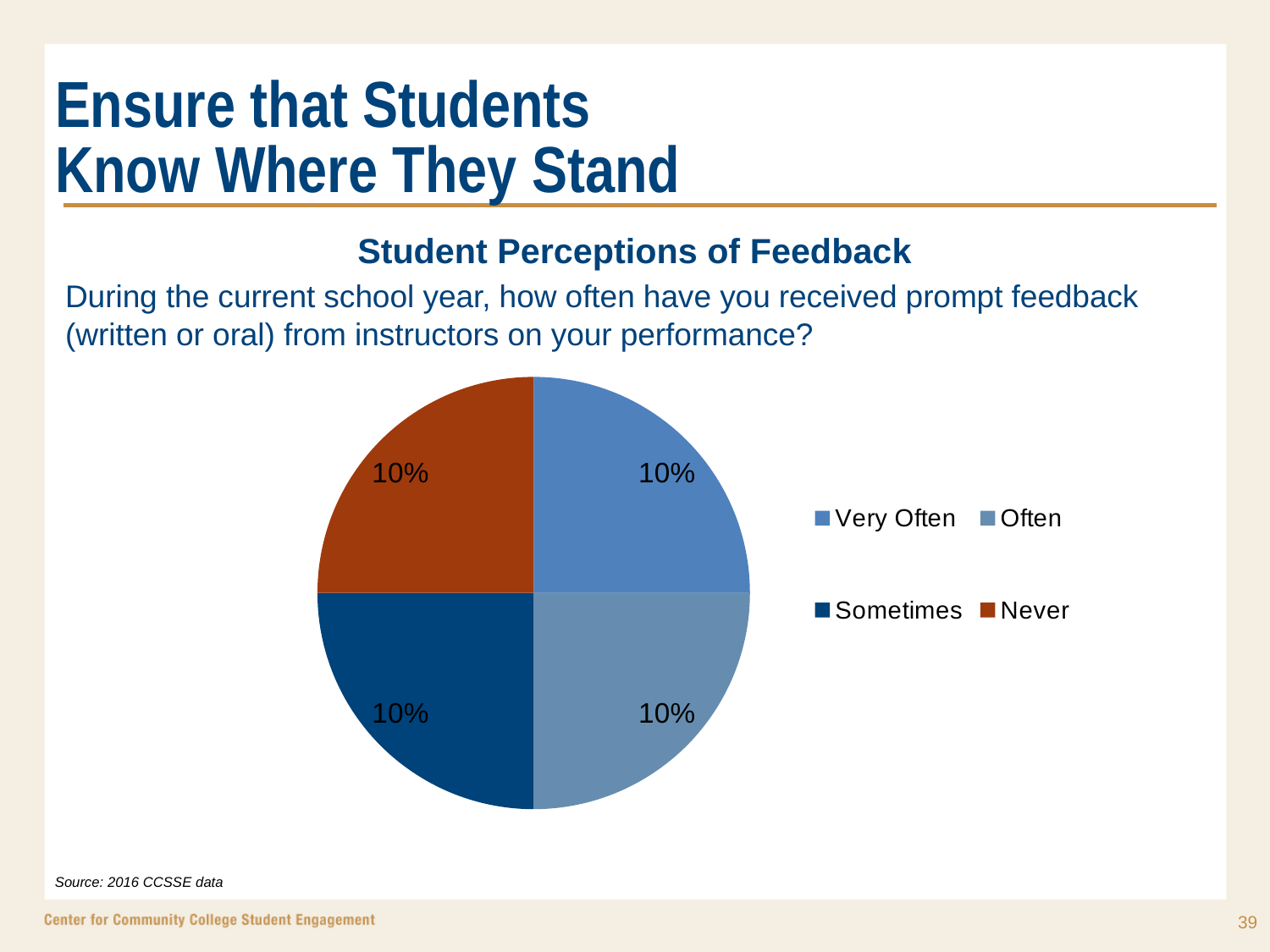
How many slices does the pie chart have? 4 What is the title of the chart? Student Perceptions of Feedback Which legend entry is shown in orange? Never What percentage is shown for the "Often" slice? 10% What share of the pie is labelled for "Never"? 10% What percentage is shown for the "Never" slice? 10% What percentage is shown for the "Sometimes" slice? 10% How many entries does the legend list? 4 What percentage is shown for the "Very Often" slice? 10% Is the value for "Sometimes" greater or less than 50%? less What kind of chart is shown on the slide? pie chart What is the difference between the labelled values for "Very Often" and "Never"? 0%